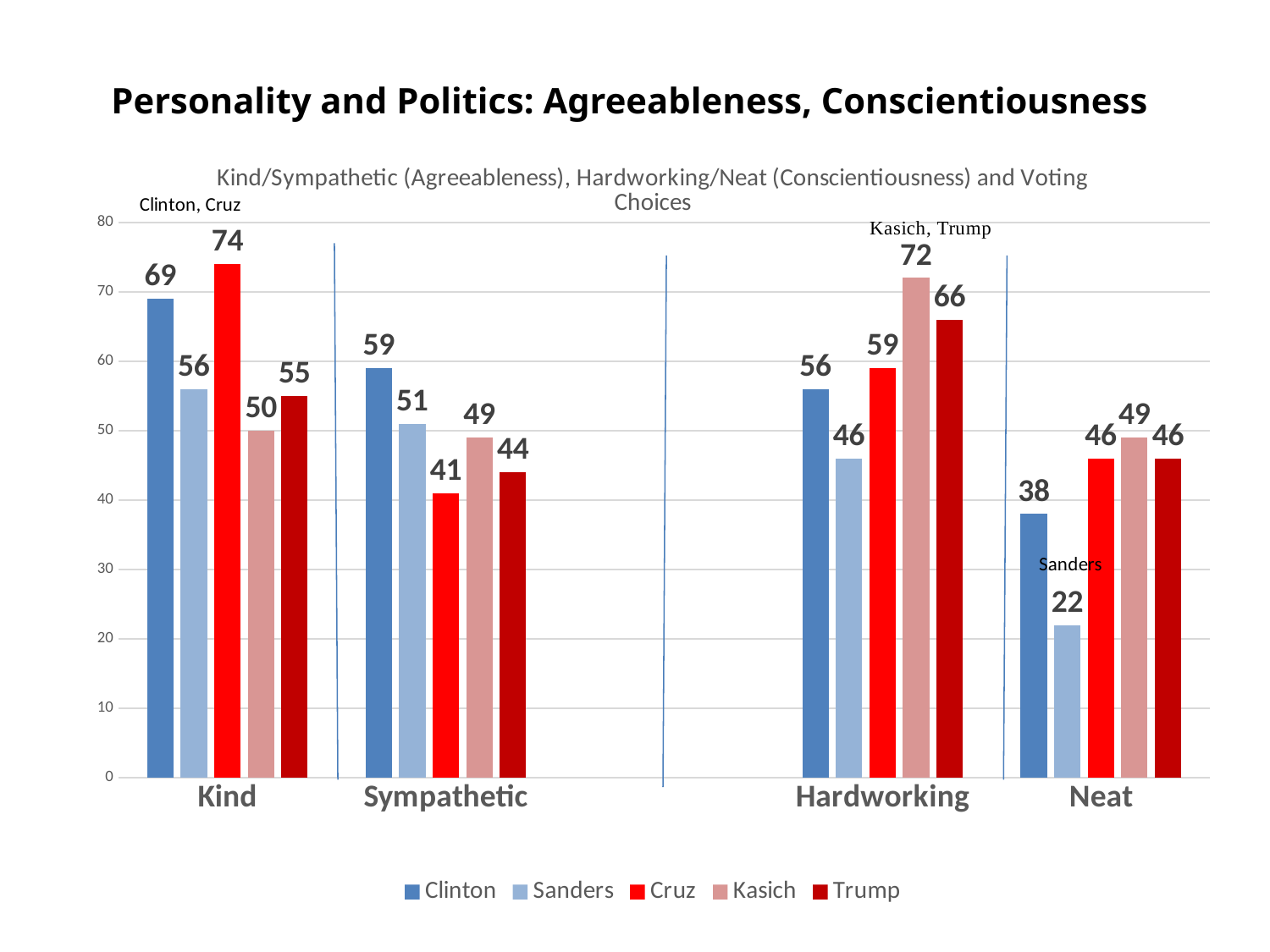
Which candidate has the highest value in the Sympathetic category? Clinton What is the difference between Clinton's and Sanders' values in the Kind category? 13 How many series does the legend list? 5 What is the value for Sanders in the Neat category? 22 How many categories are shown on the x axis? 4 Which candidate has the lowest value in the Neat category? Sanders What kind of chart is shown on the slide? Bar chart Which series is shown in the lightest blue colour in the legend? Sanders What is the value for Kasich in the Hardworking category? 72 What is the value for Cruz in the Kind category? 74 What is the difference between Kasich's and Sanders' values in the Hardworking category? 26 Which is larger in the Hardworking category: Trump's value or Cruz's value? Trump